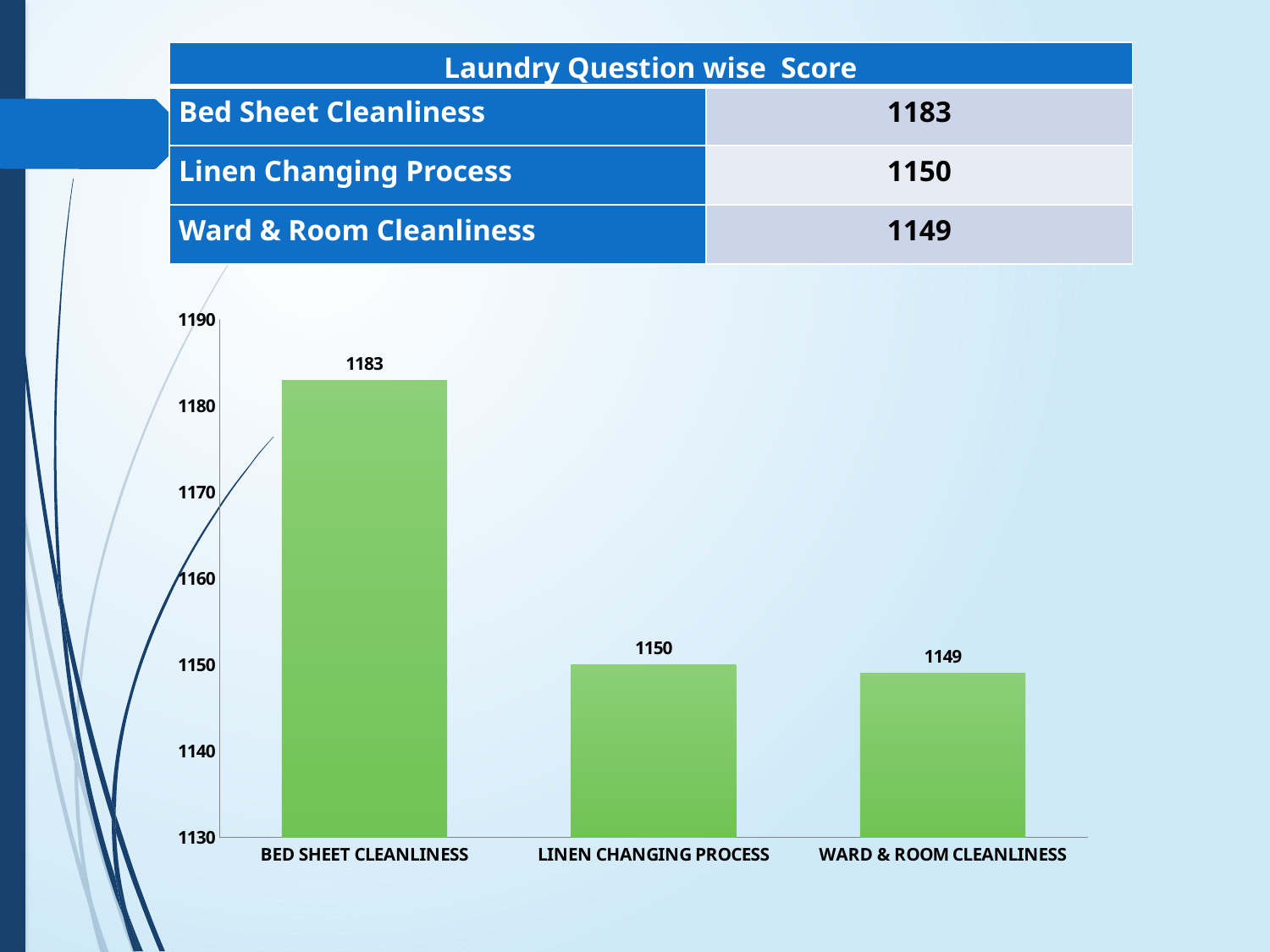
What is the value for Ward & Room Cleanliness? 1149 What kind of chart is shown on the slide? bar chart Is the value for Bed Sheet Cleanliness greater or less than 1170? greater What is the value for Bed Sheet Cleanliness? 1183 Is the value for Ward & Room Cleanliness greater or less than 1160? less Which is larger, the value for Bed Sheet Cleanliness or the value for Ward & Room Cleanliness? Bed Sheet Cleanliness What is the difference between the values for Bed Sheet Cleanliness and Linen Changing Process? 33 What is the difference between the values for Bed Sheet Cleanliness and Ward & Room Cleanliness? 34 Which category has the highest value? Bed Sheet Cleanliness What is the title of the table above the chart? Laundry Question wise Score How many categories are shown in the chart? 3 What is the value for Linen Changing Process? 1150